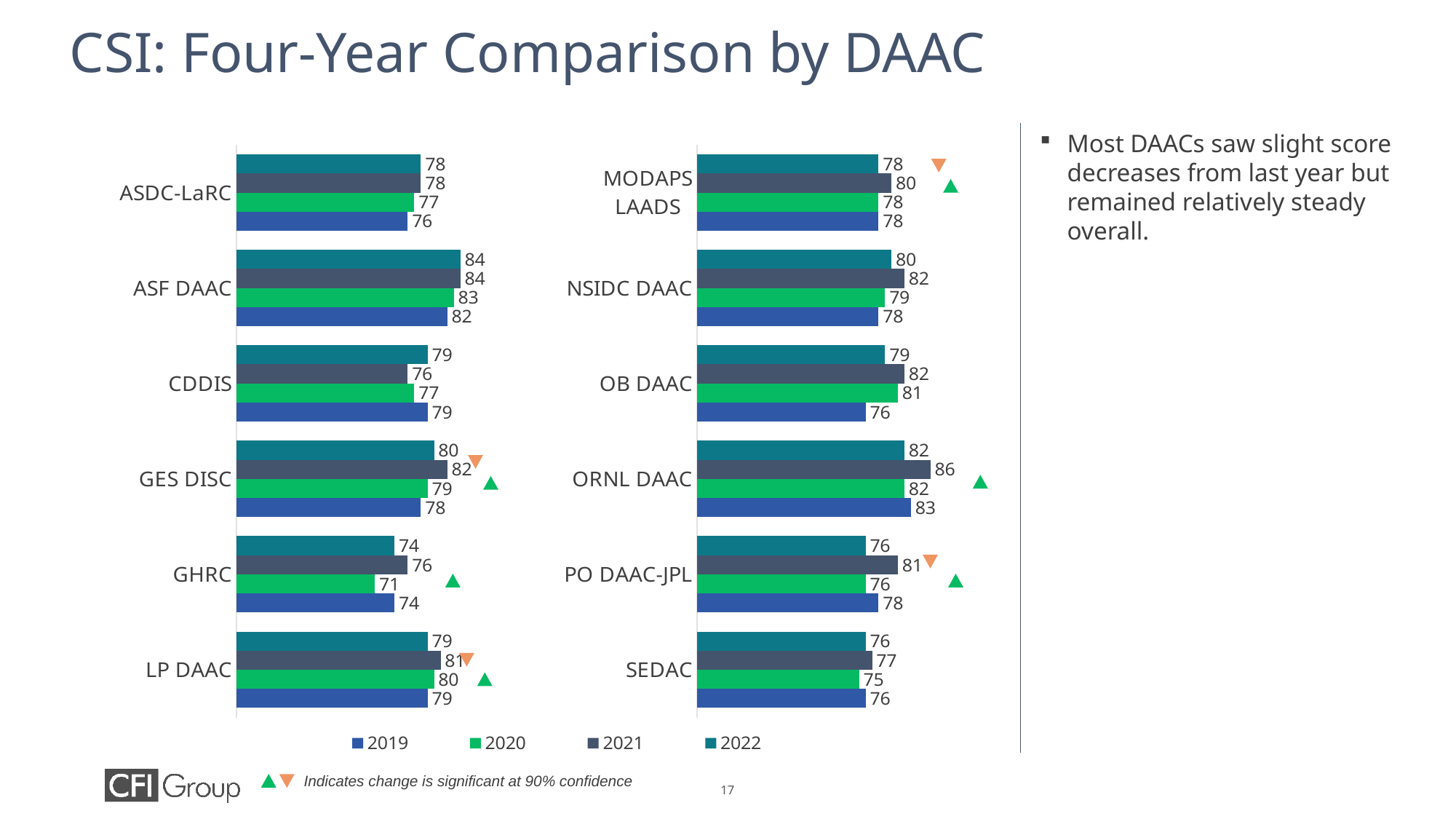
On the left chart, which DAAC has the lowest 2020 value? GHRC On the right chart, what is the 2019 value for OB DAAC? 76 On the left chart, which DAAC has the highest 2022 value? ASF DAAC On the left chart, what is the difference between the 2022 and 2021 values for CDDIS? 3 On the left chart, what is the 2022 value for ASF DAAC? 84 How many series does the legend list? 4 How many DAACs are shown on the right chart? 6 On the right chart, what is the 2021 value for ORNL DAAC? 86 On the right chart, which is larger for NSIDC DAAC: the 2021 value or the 2019 value? 2021 On the right chart, what is the difference between the 2021 and 2022 values for PO DAAC-JPL? 5 On the left chart, what is the 2020 value for GHRC? 71 What kind of chart is used on the left side of the slide? Bar chart